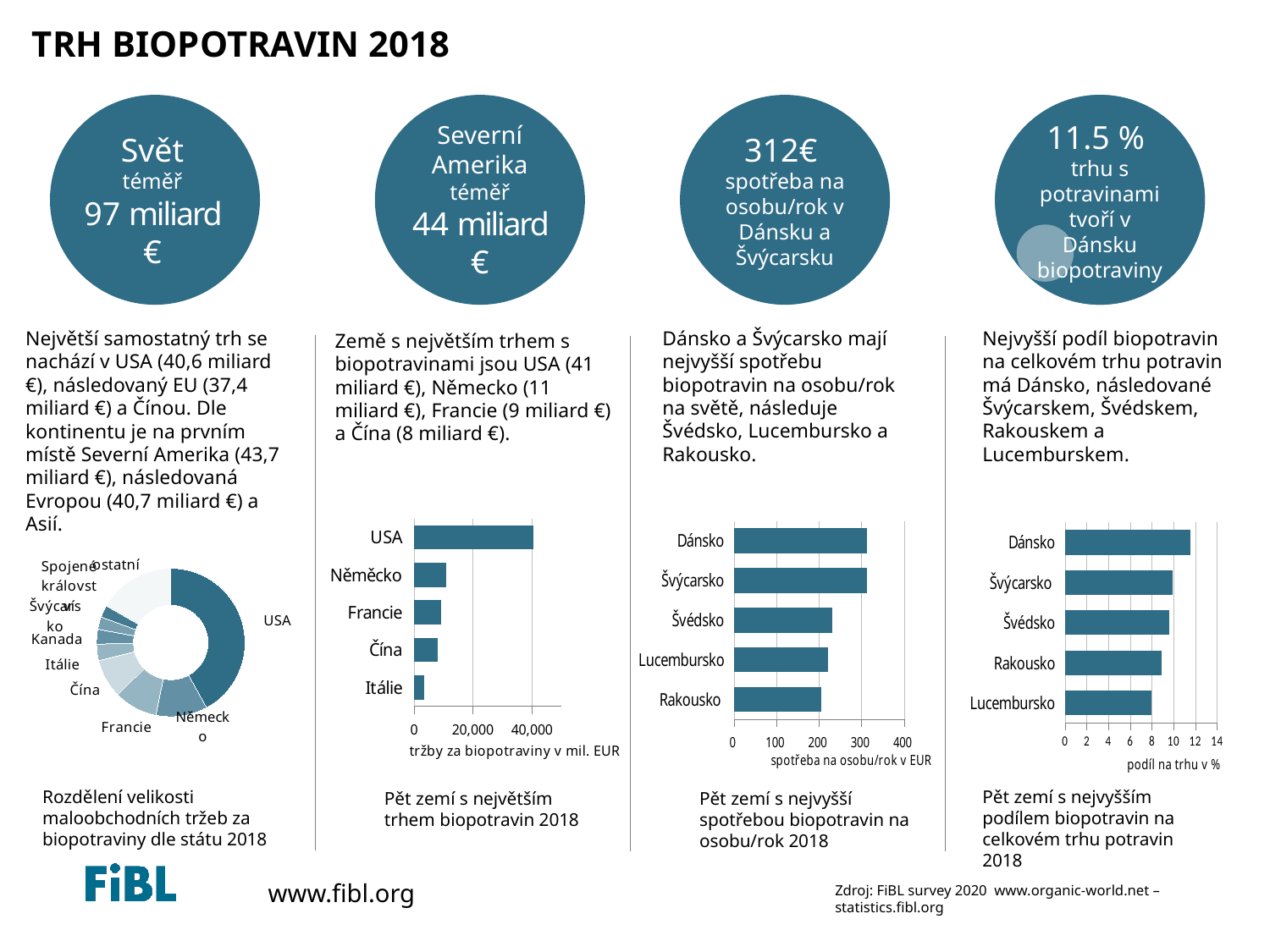
In the chart 'Pět zemí s nejvyšším podílem biopotravin na celkovém trhu potravin 2018', is the value for Dánsko greater or less than 10? greater In the chart 'Rozdělení velikosti maloobchodních tržeb za biopotraviny dle státu 2018', which country has the largest slice? USA What is the x-axis label of the chart 'Pět zemí s nejvyšší spotřebou biopotravin na osobu/rok 2018'? spotřeba na osobu/rok v EUR In the chart 'Pět zemí s nejvyšší spotřebou biopotravin na osobu/rok 2018', is the value for Dánsko greater or less than 300? greater What kind of chart is the chart titled 'Rozdělení velikosti maloobchodních tržeb za biopotraviny dle státu 2018'? Donut (pie) chart In the chart 'Pět zemí s nejvyšším podílem biopotravin na celkovém trhu potravin 2018', which country has the lowest value? Lucembursko What kind of chart is 'Pět zemí s největším trhem biopotravin 2018'? Bar chart In the chart 'Pět zemí s největším trhem biopotravin 2018', which country has the lowest value? Itálie How many slices does the chart 'Rozdělení velikosti maloobchodních tržeb za biopotraviny dle státu 2018' have? 9 In the chart 'Pět zemí s nejvyšší spotřebou biopotravin na osobu/rok 2018', is the value for Švédsko greater or less than 300? less In the chart 'Pět zemí s největším trhem biopotravin 2018', which country has the highest value? USA